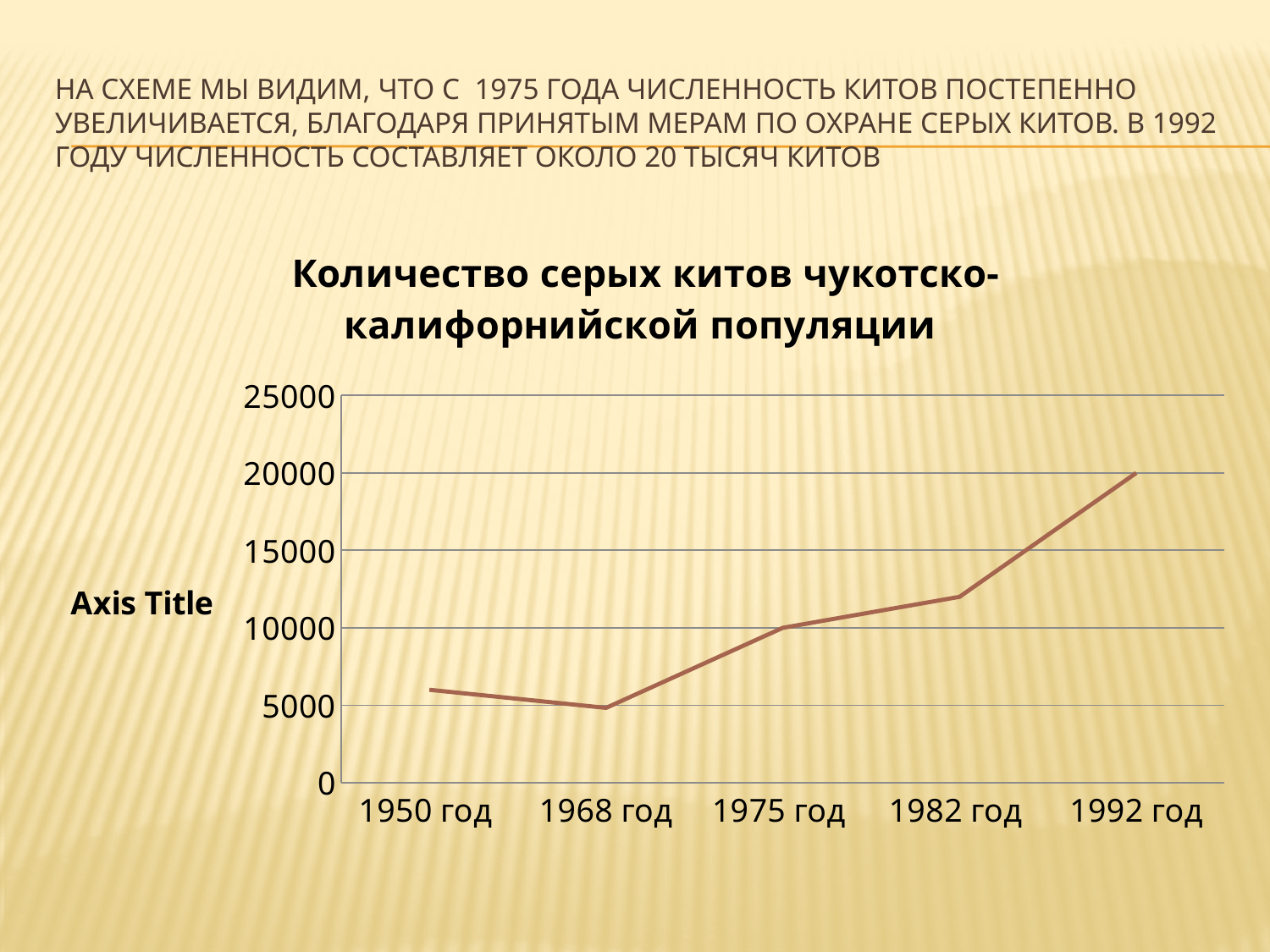
Is the value for 1982 год greater or less than 15000? less What is the value plotted for 1992 год? 20000 Which year has the highest number of grey whales on the chart? 1992 год Which year has the lowest number of grey whales on the chart? 1968 год Is the value for 1968 год greater or less than 10000? less What is the title of the chart? Количество серых китов чукотско-калифорнийской популяции Is the value for 1950 год greater or less than 5000? greater Does the number of whales rise or fall from 1975 год to 1992 год? rise What kind of chart is shown on the slide? line chart Which year has the larger value, 1950 год or 1968 год? 1950 год How many years are plotted along the x axis of the chart? 5